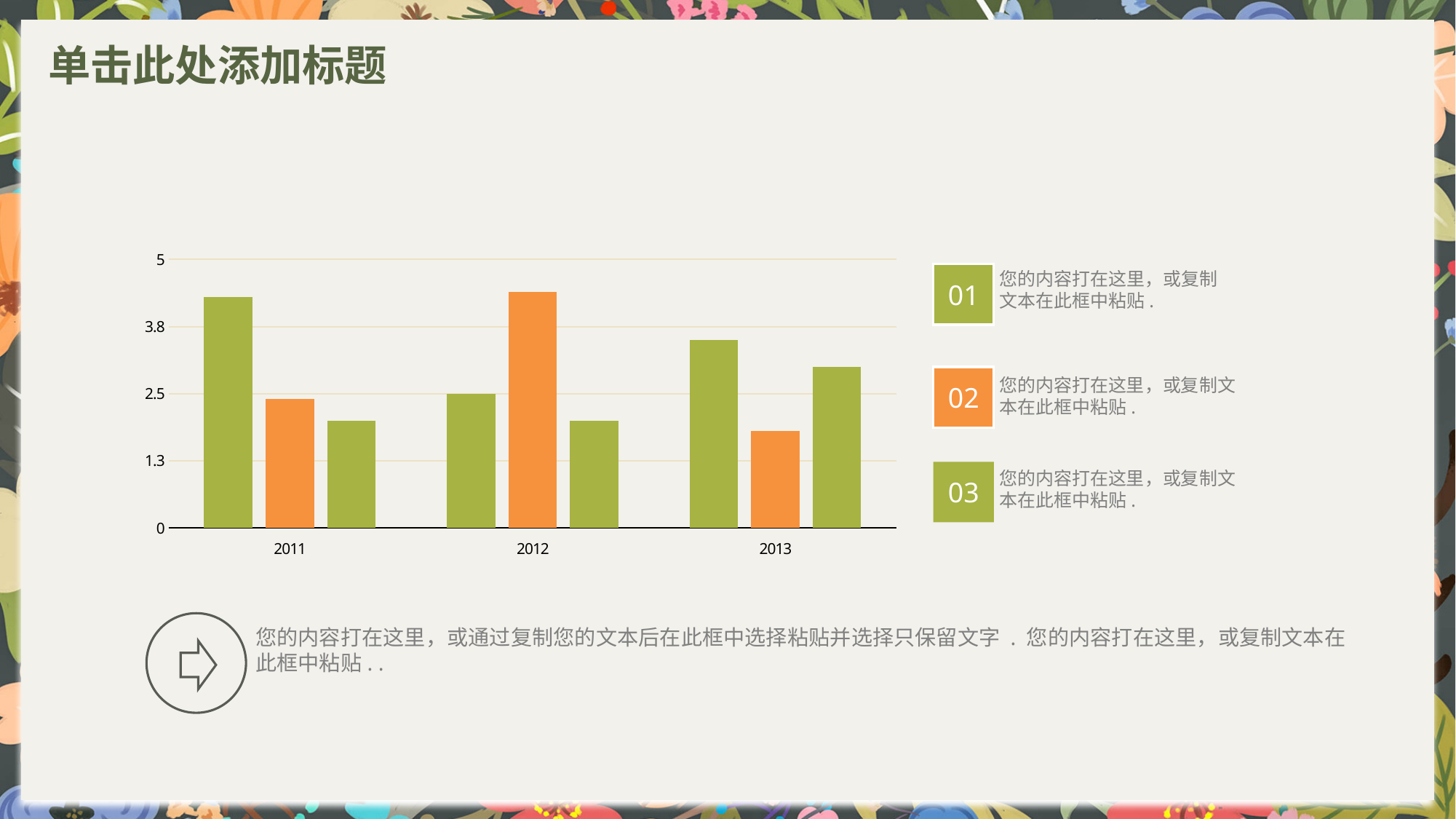
Which bar is the tallest within the 2011 group? the first (left) bar What kind of chart is shown on the slide? bar chart Is the value of the first (left) bar in the 2011 group greater or less than 3.8? greater Is the value of the third (right) bar in the 2013 group greater or less than 2.5? greater Which bar is the shortest within the 2013 group? the middle (orange) bar How many categories are shown on the x axis of the chart? 3 Is the value of the middle (orange) bar in the 2013 group greater or less than 2.5? less Which is larger: the first (left) bar in 2011 or the first (left) bar in 2012? the first bar in 2011 What colour is the middle bar in each year group? orange How many bars are plotted in total on the chart? 9 What is the value of the first (left) bar in the 2012 group? 2.5